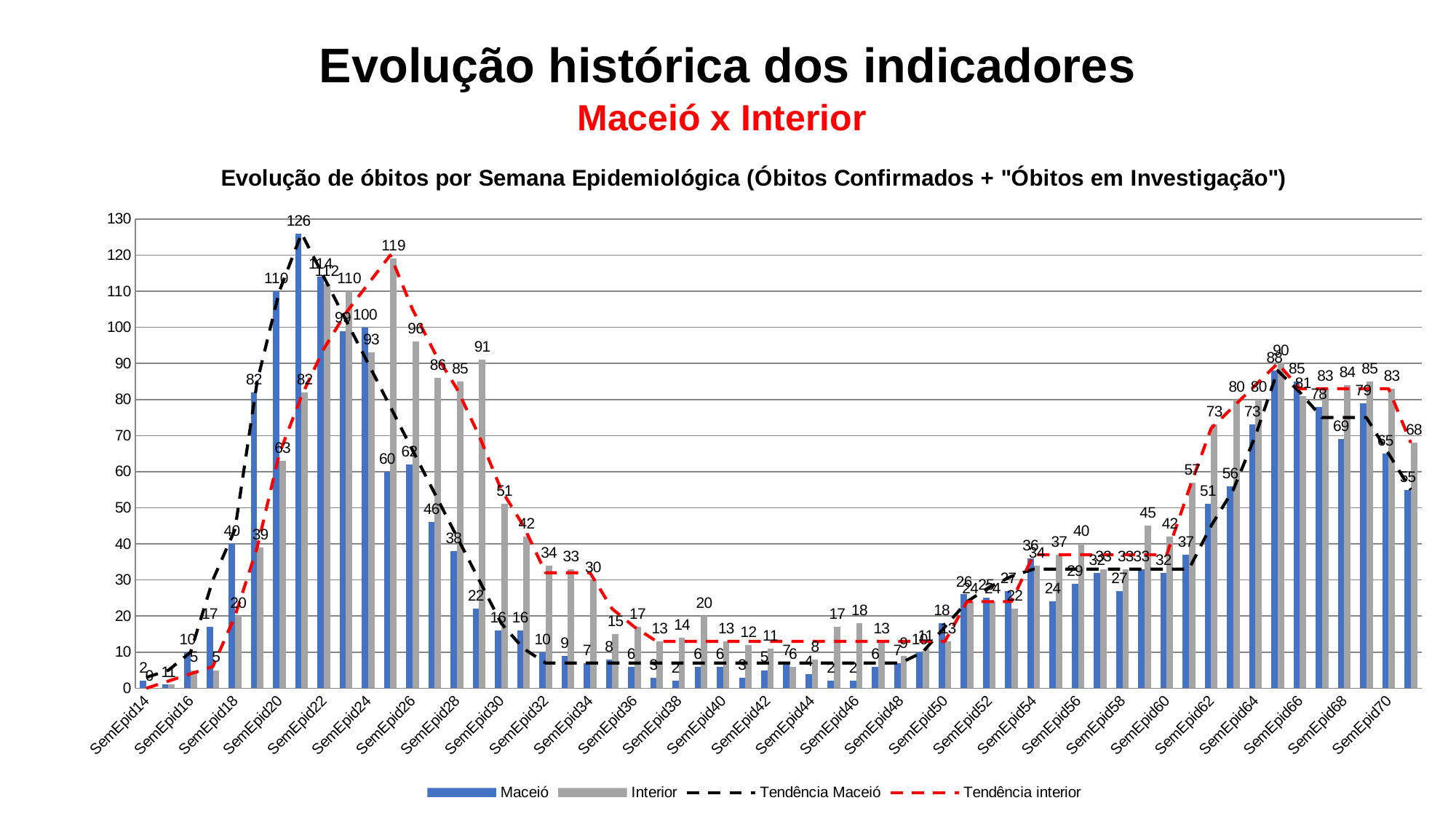
Do the Maceió values rise or fall from SemEpid22 to SemEpid38? fall What is the highest value reached by the Interior series? 119 What is the Maceió value at SemEpid18? 40 What kind of chart is shown on the slide? bar and line chart What is the highest value reached by the Maceió series? 126 What is the Interior value at SemEpid22? 112 How many entries does the chart legend list? 4 At SemEpid20, what is the difference between the Maceió value and the Interior value? 47 What is the Maceió value at SemEpid20? 110 What is the Interior value at SemEpid30? 51 What colour are the Interior bars in the chart? gray At SemEpid28, which series has the larger value, Maceió or Interior? Interior